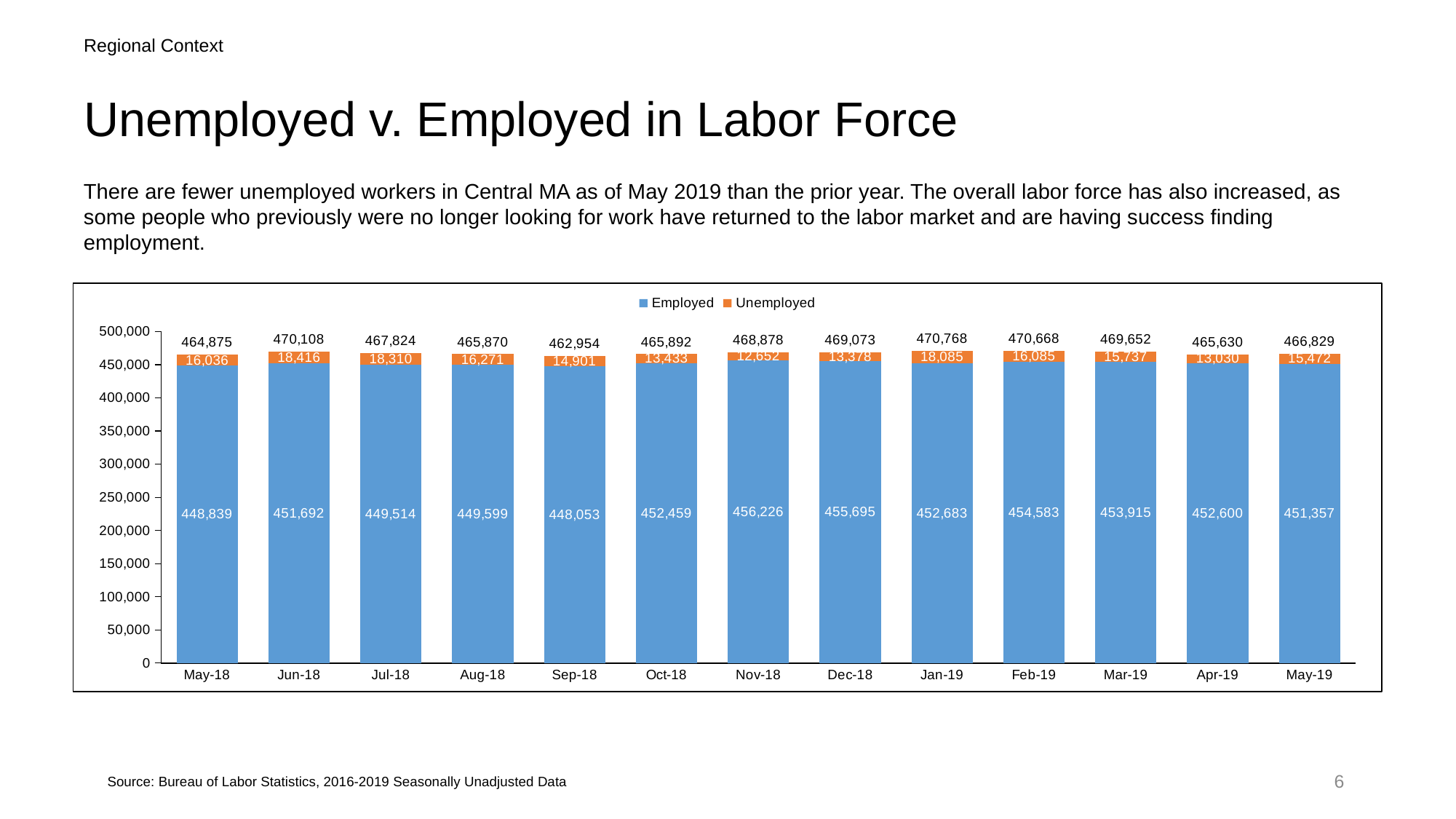
Which is larger, the Employed value for Dec-18 or for Apr-19? Dec-18 What is the Unemployed value for May-19? 15,472 What is the total labor force (Employed plus Unemployed) shown for Jan-19? 470,768 Which month has the highest Unemployed value? Jun-18 Is the Employed value for Sep-18 greater or less than 400,000? greater Which month has the lowest Unemployed value? Nov-18 How many series does the legend list? 2 Which month has the lowest Employed value? Sep-18 How many months are shown on the x axis? 13 What kind of chart is shown on the slide? Stacked bar chart What is the Employed value for Nov-18? 456,226 How much lower is the Unemployed value in May-19 than in May-18? 564